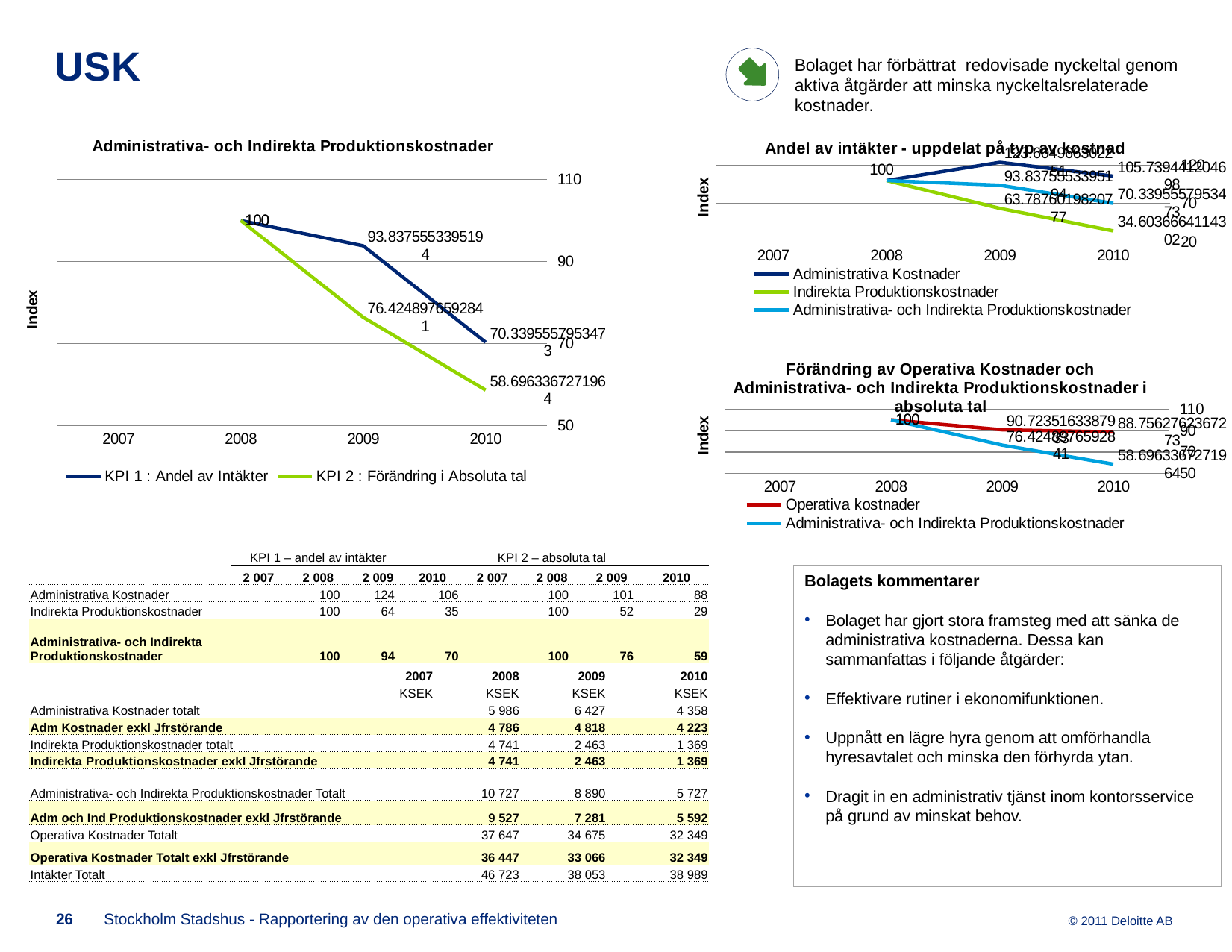
In the 'Administrativa- och Indirekta Produktionskostnader' chart, how many series does the legend list? 2 In the 'Andel av intäkter - uppdelat på typ av kostnad' chart, how many series does the legend list? 3 In the 'Administrativa- och Indirekta Produktionskostnader' chart, what is the value of KPI 2 : Förändring i Absoluta tal in 2010? 58.6963367271964 In the 'Andel av intäkter - uppdelat på typ av kostnad' chart, which series has the lowest value in 2010? Indirekta Produktionskostnader In the 'Förändring av Operativa Kostnader och Administrativa- och Indirekta Produktionskostnader i absoluta tal' chart, what colour is the line for Operativa kostnader? red In the 'Administrativa- och Indirekta Produktionskostnader' chart, how many years are shown on the x axis? 4 What kind of chart is the 'Administrativa- och Indirekta Produktionskostnader' chart? line chart In the 'Förändring av Operativa Kostnader och Administrativa- och Indirekta Produktionskostnader i absoluta tal' chart, which series has the higher value in 2010, Operativa kostnader or Administrativa- och Indirekta Produktionskostnader? Operativa kostnader In the 'Administrativa- och Indirekta Produktionskostnader' chart, do the values of KPI 1 : Andel av Intäkter rise or fall from 2008 to 2010? fall In the 'Administrativa- och Indirekta Produktionskostnader' chart, which series has the higher value in 2009, KPI 1 : Andel av Intäkter or KPI 2 : Förändring i Absoluta tal? KPI 1 : Andel av Intäkter In the 'Administrativa- och Indirekta Produktionskostnader' chart, what is the value of KPI 1 : Andel av Intäkter in 2008? 100 In the 'Administrativa- och Indirekta Produktionskostnader' chart, is the value of KPI 2 : Förändring i Absoluta tal in 2010 greater or less than 70? less